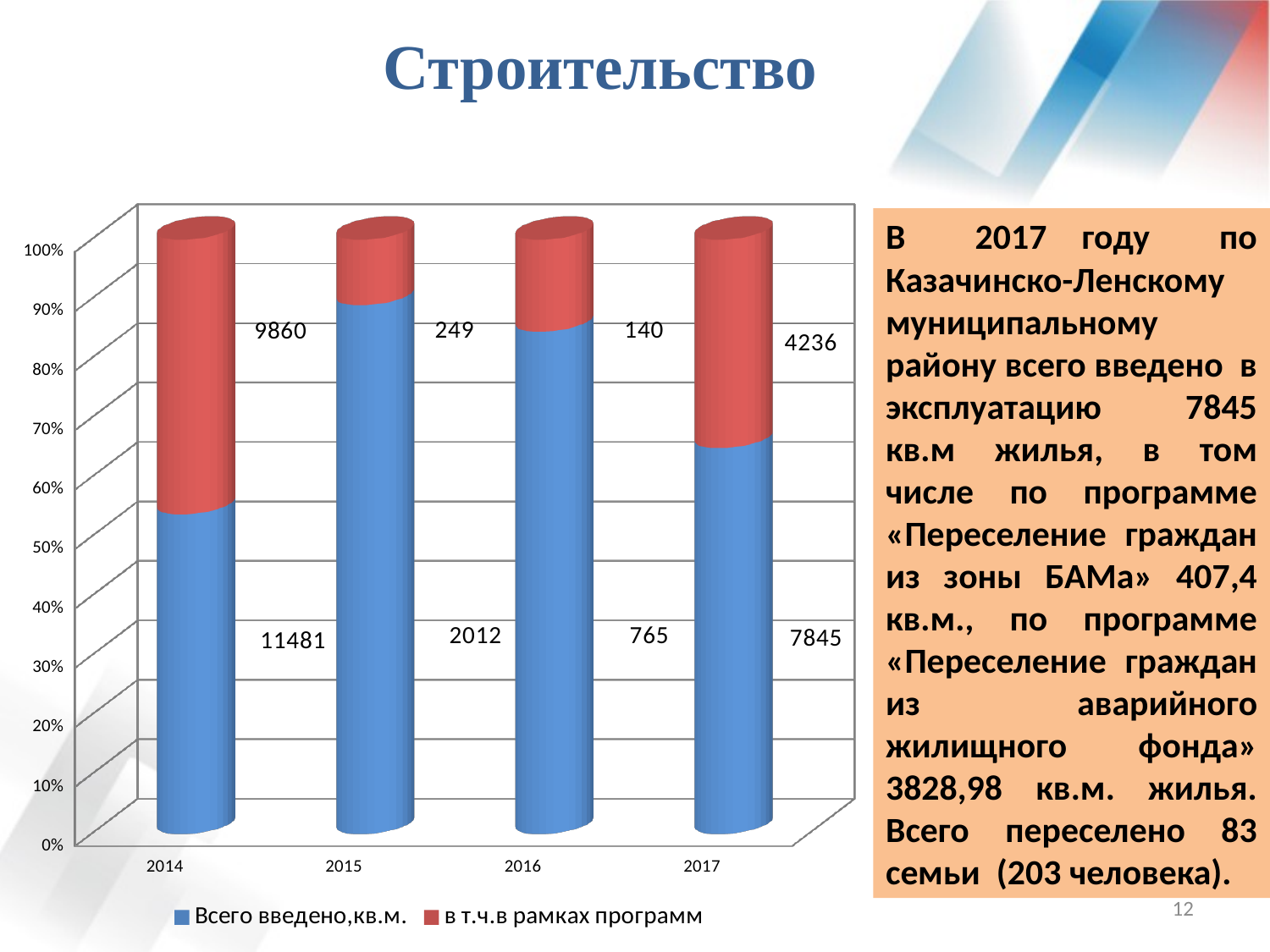
What is the value of the 'Всего введено,кв.м.' series for 2014? 11481 What is the value of the 'Всего введено,кв.м.' series for 2016? 765 What is the value of the 'в т.ч.в рамках программ' series for 2017? 4236 Which year has the lowest value for the 'в т.ч.в рамках программ' series? 2016 What is the value of the 'в т.ч.в рамках программ' series for 2015? 249 Which is larger: the 'в т.ч.в рамках программ' value for 2014 or for 2017? 2014 What is the title of the slide containing the chart? Строительство Which year has the highest value for the 'Всего введено,кв.м.' series? 2014 What is the difference between the 'Всего введено,кв.м.' values for 2017 and 2015? 5833 What kind of chart is shown on the slide? Stacked bar chart How many series does the chart legend list? 2 How many years are shown on the x axis of the chart? 4